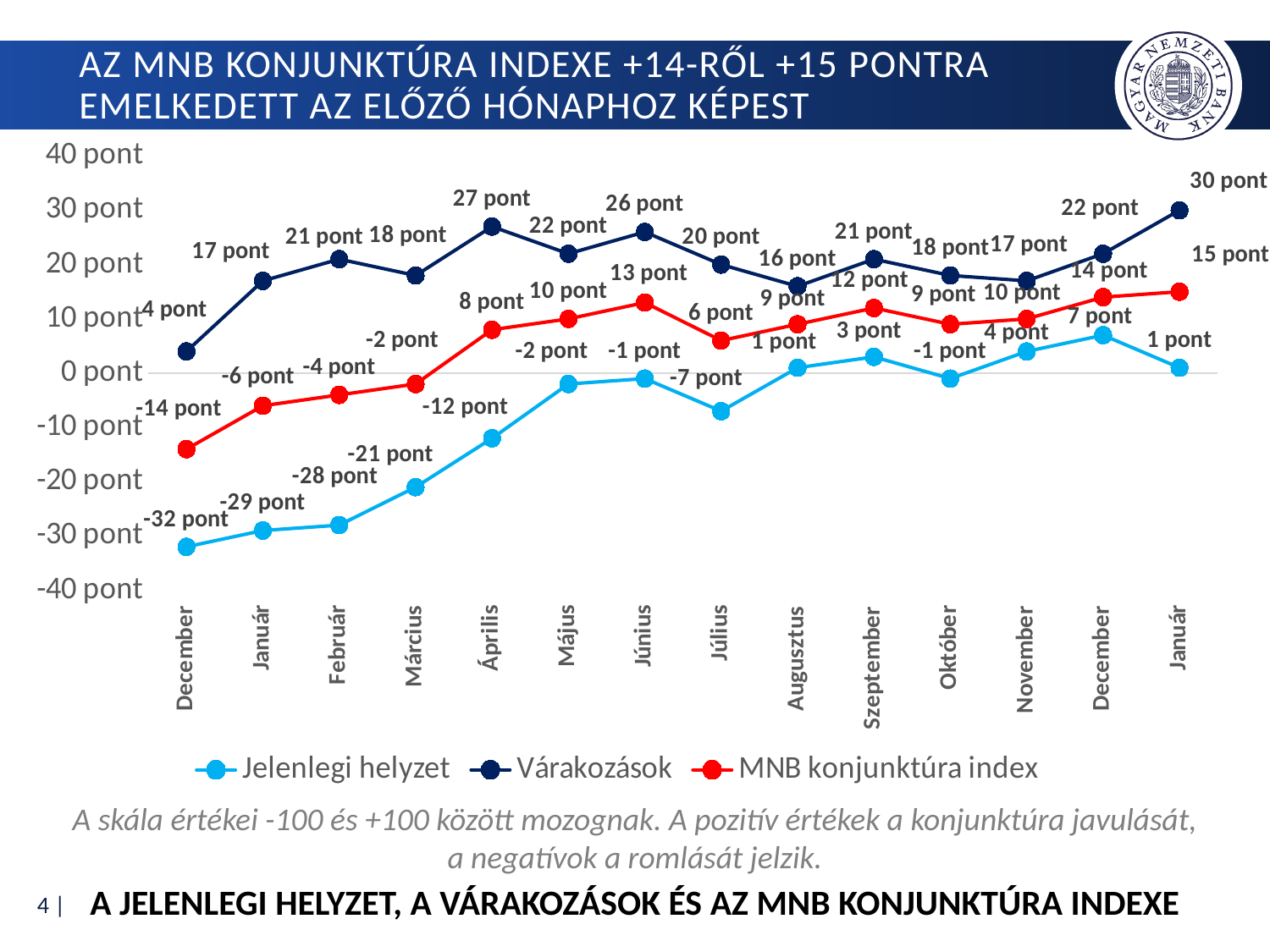
What is the value of Várakozások in Április? 27 pont How many months are plotted along the x axis? 14 Which is larger in Július: the MNB konjunktúra index or Jelenlegi helyzet? MNB konjunktúra index How many series does the legend list? 3 What type of chart is shown on the slide? line chart Does the Jelenlegi helyzet series generally rise or fall from the first December to the last Január? rise In which month does Várakozások reach its highest value? Január (the last one) What is the value of the MNB konjunktúra index for the last Január on the x axis? 15 pont Which colour is used for the Várakozások series? dark navy blue What is the difference between Várakozások and Jelenlegi helyzet in Június? 27 pont In which month is Jelenlegi helyzet at its lowest? December (the first one) What is the value of Jelenlegi helyzet in the first December on the x axis? -32 pont